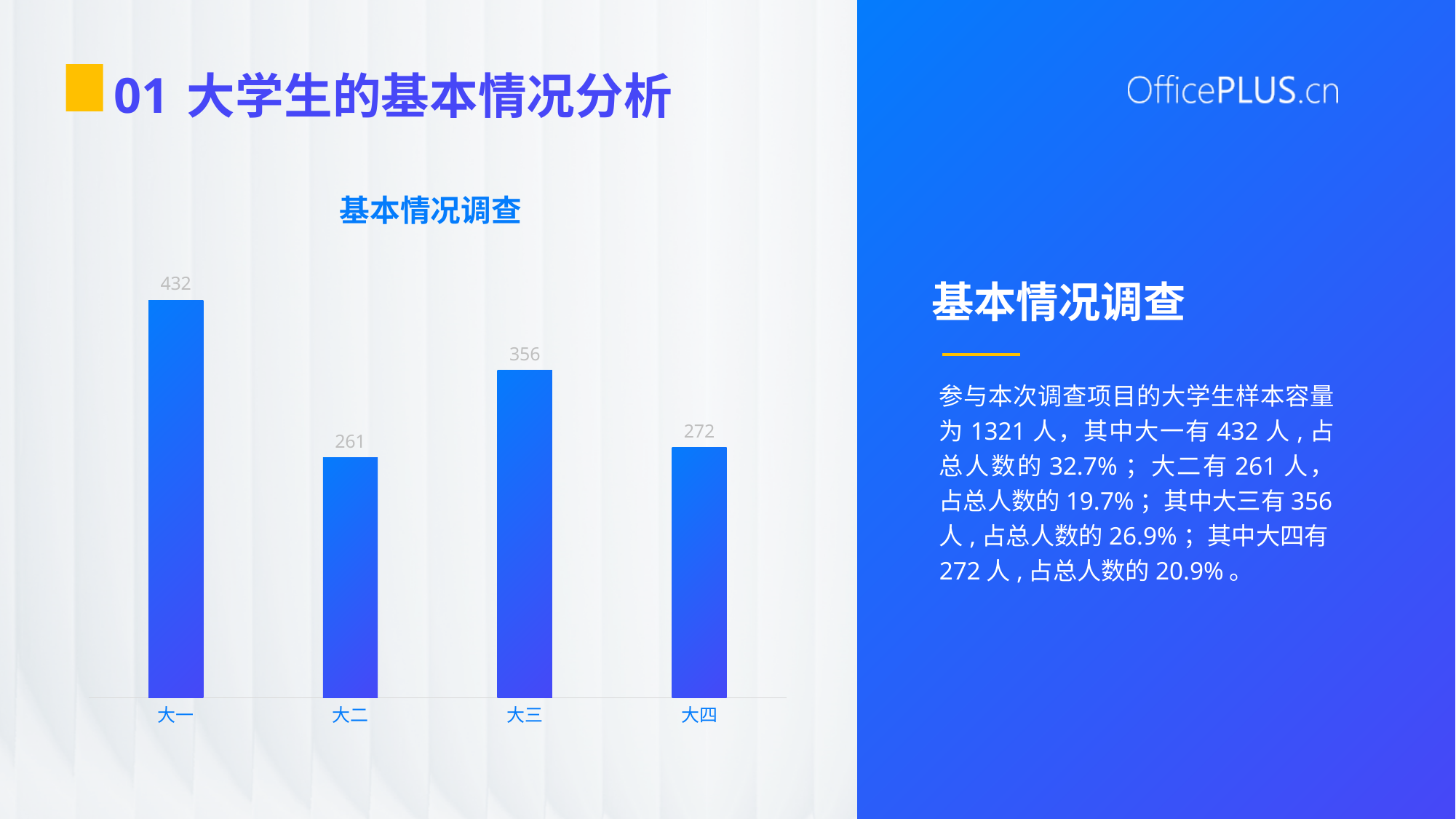
What is the value for 大四? 272 Which category has the lowest value? 大二 What is the difference between the values for 大四 and 大二? 11 Which category has the highest value? 大一 What is the title of the chart? 基本情况调查 What kind of chart is shown? bar chart What is the value for 大三? 356 What is the difference between the values for 大一 and 大三? 76 Which is larger, the value for 大三 or the value for 大四? 大三 How many categories are shown on the x axis? 4 What is the value for 大二? 261 What is the value for 大一? 432